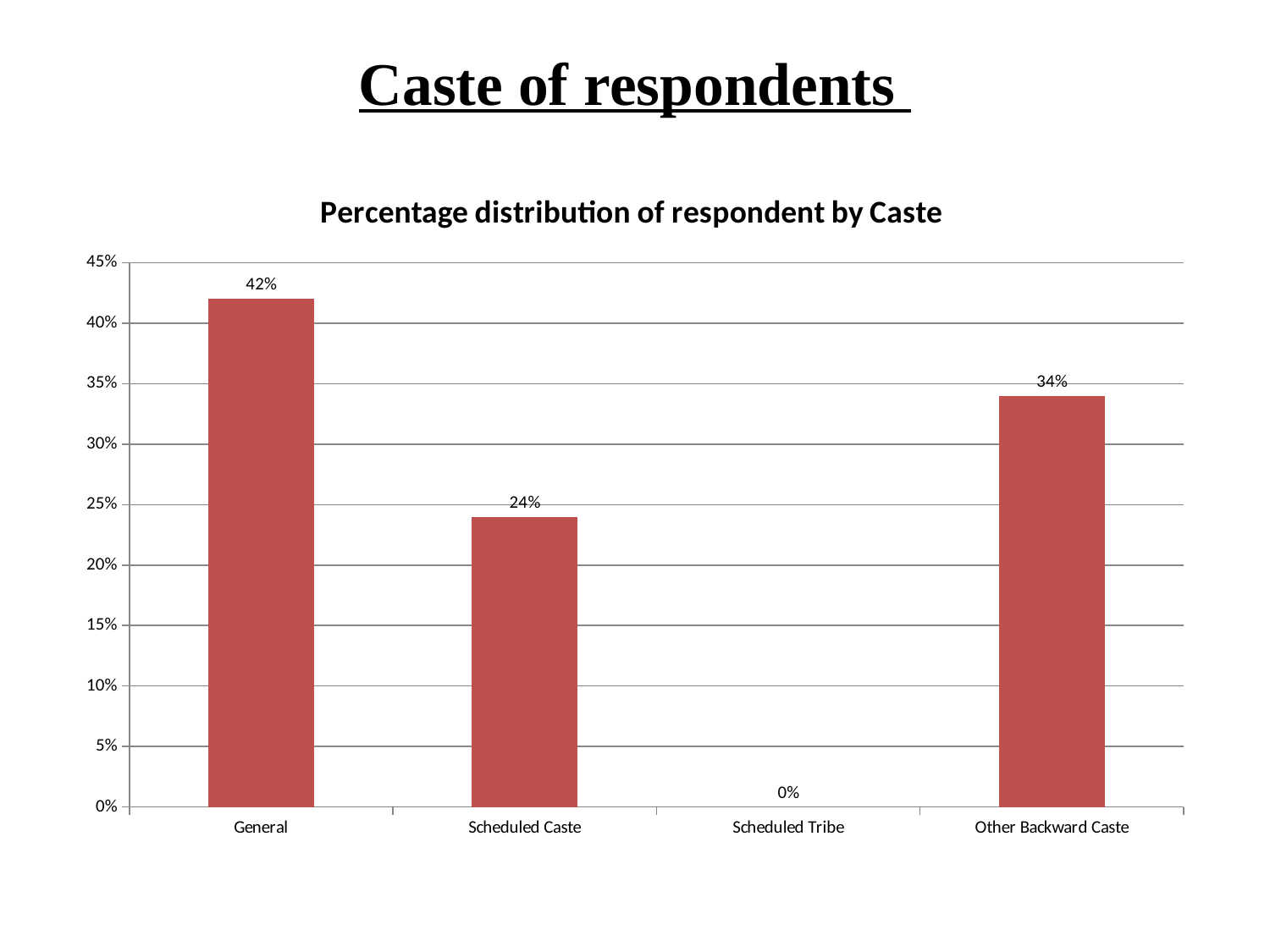
Which caste category has the lowest percentage of respondents? Scheduled Tribe What percentage of respondents are Scheduled Caste? 24% What is the title of the chart? Percentage distribution of respondent by Caste What is the difference in percentage points between Other Backward Caste and Scheduled Caste respondents? 10% What percentage of respondents are Scheduled Tribe? 0% Which has a larger share of respondents, Scheduled Caste or Other Backward Caste? Other Backward Caste What percentage of respondents are General caste? 42% What percentage of respondents are Other Backward Caste? 34% Which caste category has the highest percentage of respondents? General What is the difference in percentage points between General and Scheduled Caste respondents? 18% What type of chart is used to show the distribution of respondents by caste? Bar chart How many caste categories are shown on the chart? 4